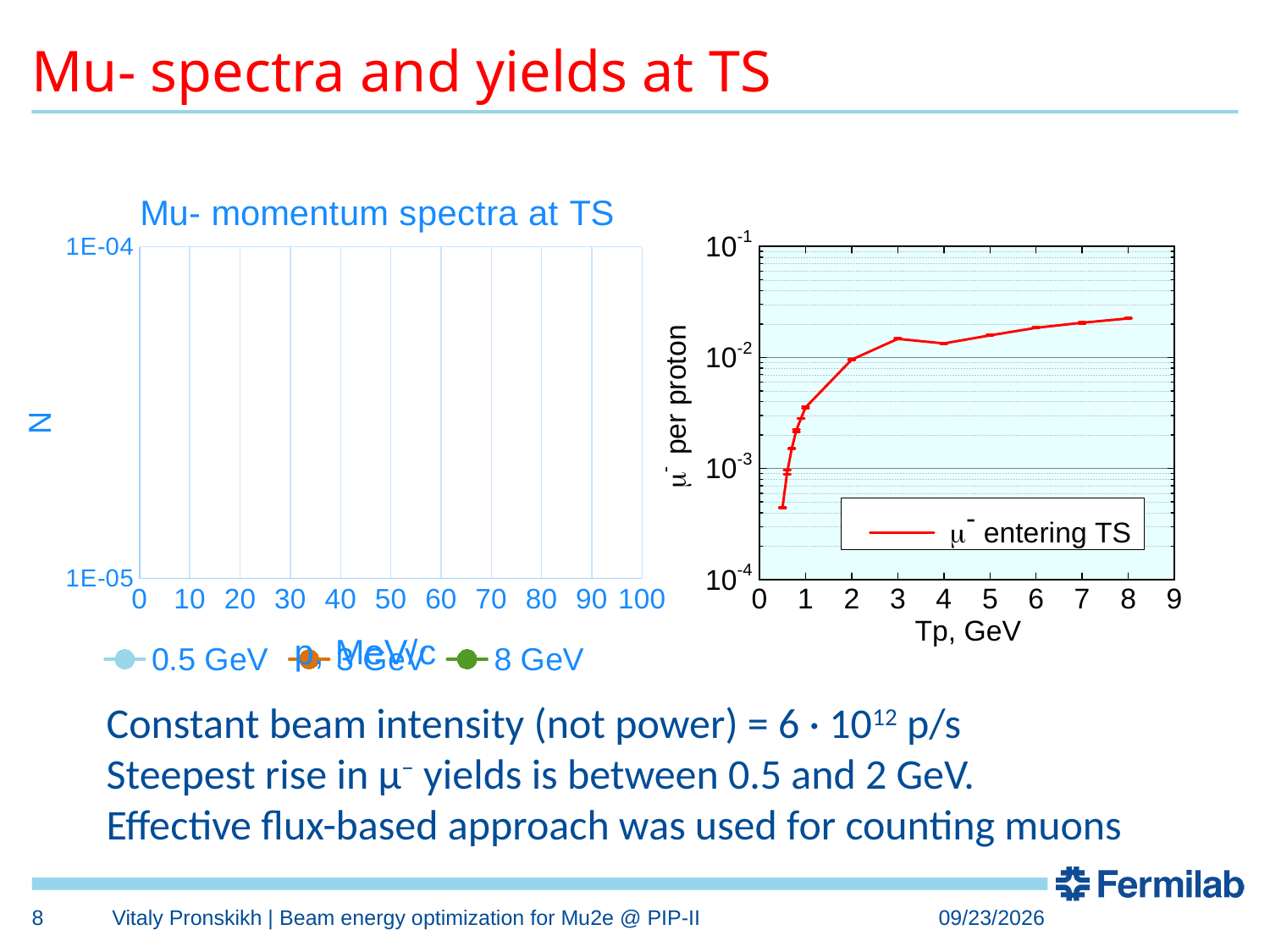
What are the legend entries of the left-hand chart 'Mu- momentum spectra at TS'? 0.5 GeV, 3 GeV, 8 GeV How many series does the legend of the left-hand chart 'Mu- momentum spectra at TS' list? 3 In the right-hand chart, is the lowest plotted μ⁻ per proton value (at about 0.5 GeV) greater or less than 10^-3? less In the right-hand chart, at which Tp value is the μ⁻ per proton highest? 8 GeV In the right-hand chart, is the μ⁻ per proton value at Tp = 1 GeV greater or less than 10^-2? less What is the x-axis label of the right-hand chart? Tp, GeV What kind of chart is the right-hand chart (μ⁻ per proton vs Tp, GeV)? line chart In the right-hand chart, is the μ⁻ per proton value at Tp = 8 GeV greater or less than 10^-2? greater In the right-hand chart, which has the larger μ⁻ per proton value: Tp = 1 GeV or Tp = 8 GeV? 8 GeV In the right-hand chart, does the μ⁻ per proton value generally rise or fall as Tp increases from 0.5 to 8 GeV? rise